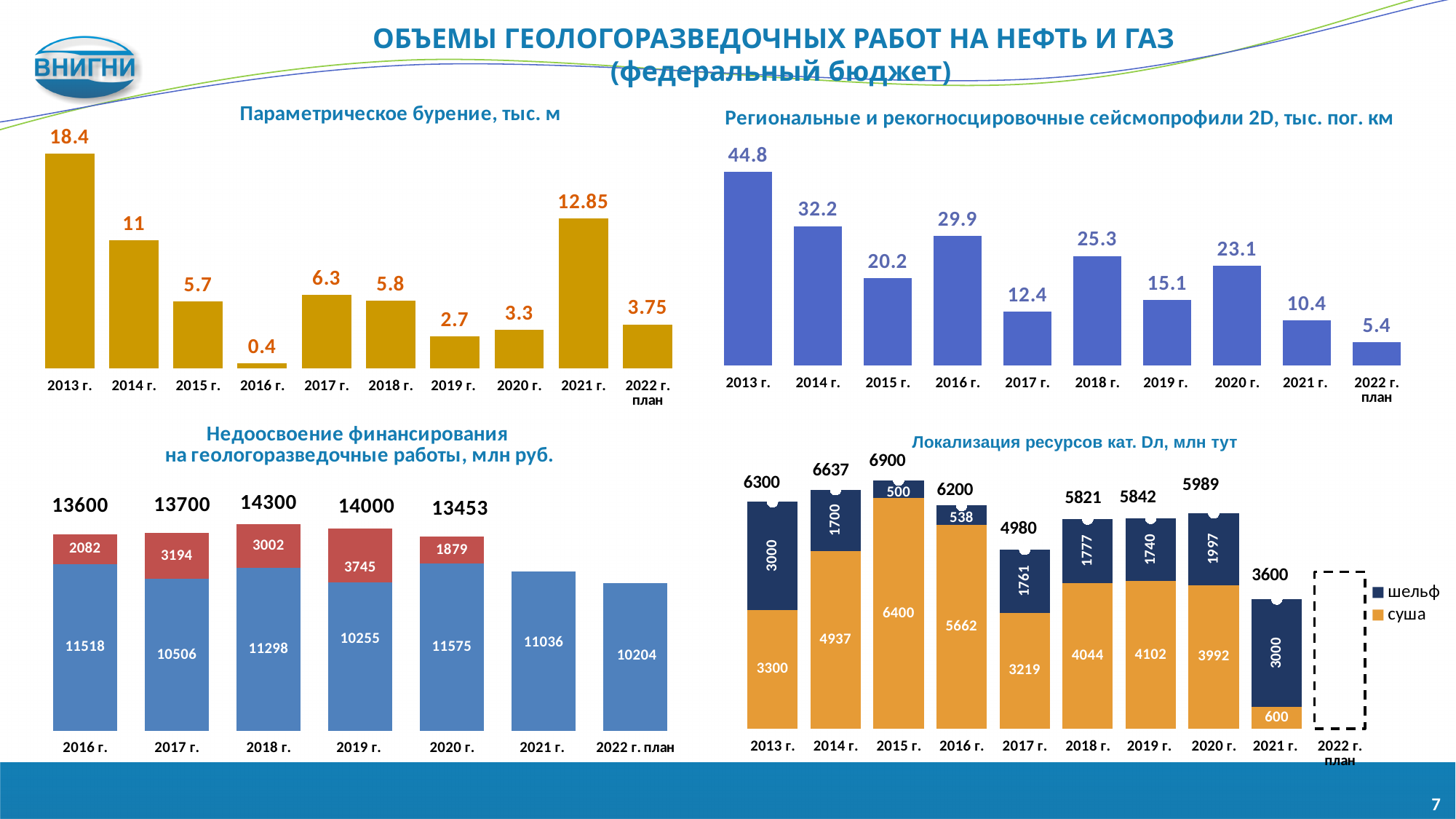
In the chart 'Параметрическое бурение, тыс. м', what is the value for 2021 г.? 12.85 In the chart 'Недоосвоение финансирования на геологоразведочные работы, млн руб.', what is the value of the red (top) segment for 2019 г.? 3745 In the chart 'Локализация ресурсов кат. Dл, млн тут', how many series does the legend list? 2 In the chart 'Региональные и рекогносцировочные сейсмопрофили 2D, тыс. пог. км', what is the value for 2018 г.? 25.3 In the chart 'Параметрическое бурение, тыс. м', which year has the lowest value? 2016 г. What kind of chart is 'Параметрическое бурение, тыс. м'? Bar chart In the chart 'Региональные и рекогносцировочные сейсмопрофили 2D, тыс. пог. км', which year has the highest value? 2013 г. In the chart 'Региональные и рекогносцировочные сейсмопрофили 2D, тыс. пог. км', what is the difference between the values for 2014 г. and 2015 г.? 12 In the chart 'Региональные и рекогносцировочные сейсмопрофили 2D, тыс. пог. км', how many years are shown on the x axis? 10 In the chart 'Недоосвоение финансирования на геологоразведочные работы, млн руб.', what is the total for the 2018 г. bar? 14300 In the chart 'Локализация ресурсов кат. Dл, млн тут', what is the 'суша' value for 2015 г.? 6400 In the chart 'Локализация ресурсов кат. Dл, млн тут', which is larger: the 'шельф' value for 2014 г. or the 'шельф' value for 2016 г.? 2014 г.